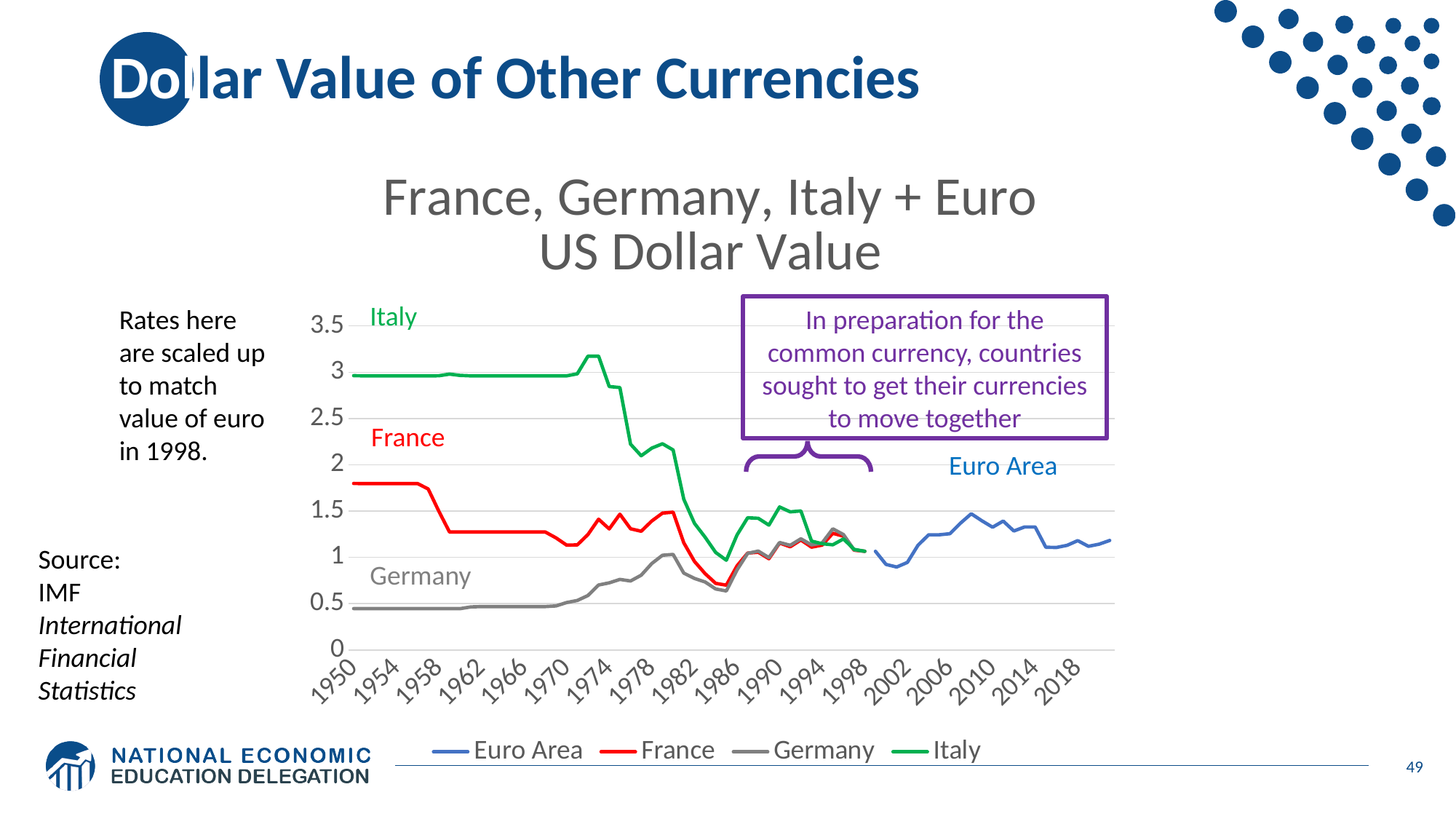
Is the value for Germany in 1950 greater or less than 1? less In 1950, which is higher, France or Germany? France Which series has the highest value in 1950? Italy What kind of chart is shown on the slide? line chart Is the value for Euro Area in 2010 greater or less than 1? greater What are the series listed in the chart legend? Euro Area, France, Germany, Italy Is the value for Italy in 1950 greater or less than 2.5? greater Does the Italy line rise or fall between 1950 and 1986? fall How many series does the chart legend list? 4 Which series has the lowest value in 1950? Germany What is the title of the chart? France, Germany, Italy + Euro US Dollar Value